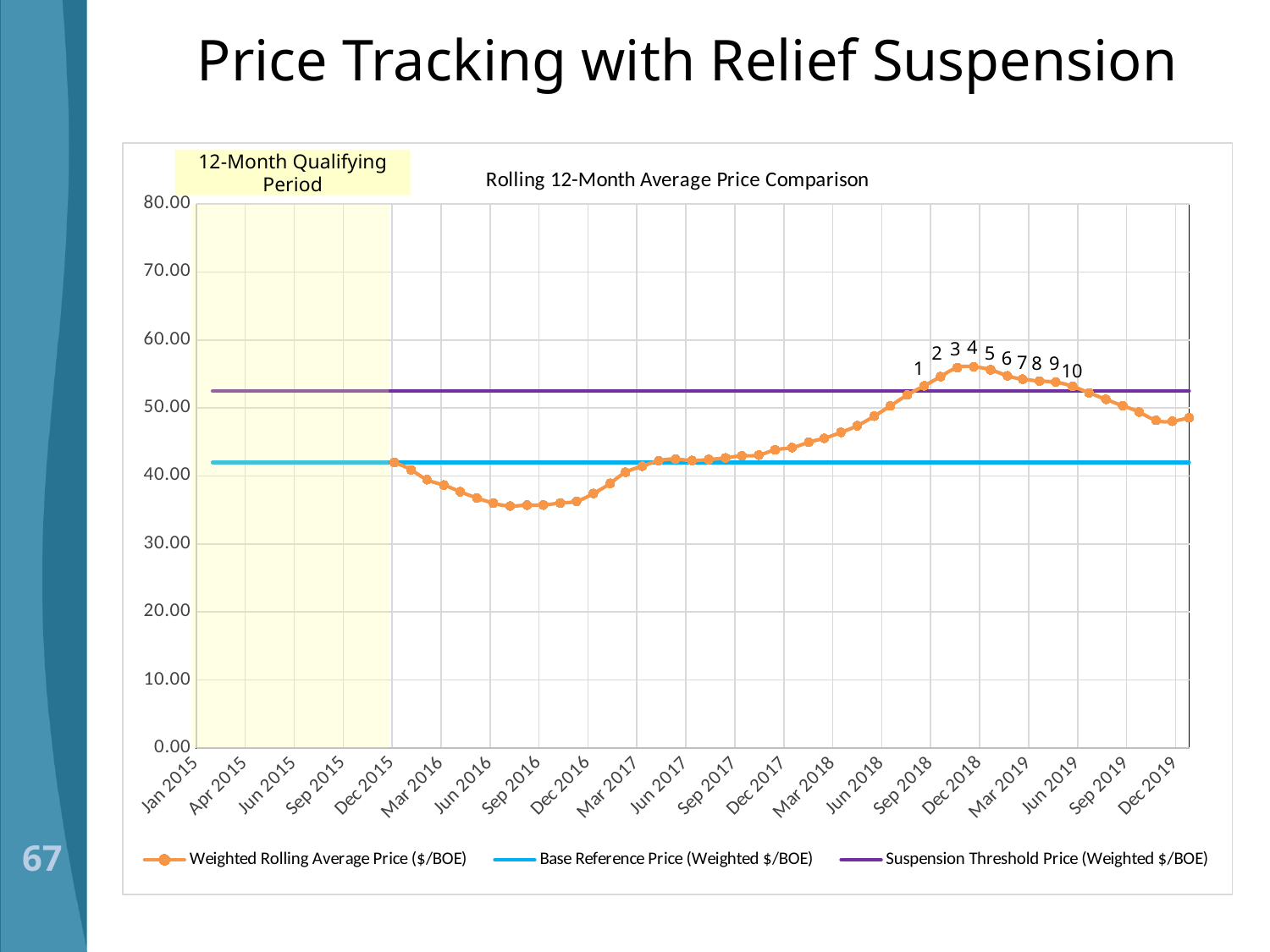
What is the title of the chart? Rolling 12-Month Average Price Comparison Is the Base Reference Price line greater or less than 50.00? less Which is higher, the Suspension Threshold Price or the Base Reference Price? Suspension Threshold Price Does the Weighted Rolling Average Price rise or fall between Sep 2016 and Dec 2018? rise What kind of chart is shown on the slide? Line chart Is the Weighted Rolling Average Price for Sep 2016 greater or less than 40.00? less Is the Suspension Threshold Price line greater or less than 50.00? greater What label is shown above the shaded region at the left of the chart? 12-Month Qualifying Period How many numbered points are marked above the Suspension Threshold Price line? 10 How many series does the chart legend list? 3 Does the Weighted Rolling Average Price rise or fall between Dec 2018 and Sep 2019? fall